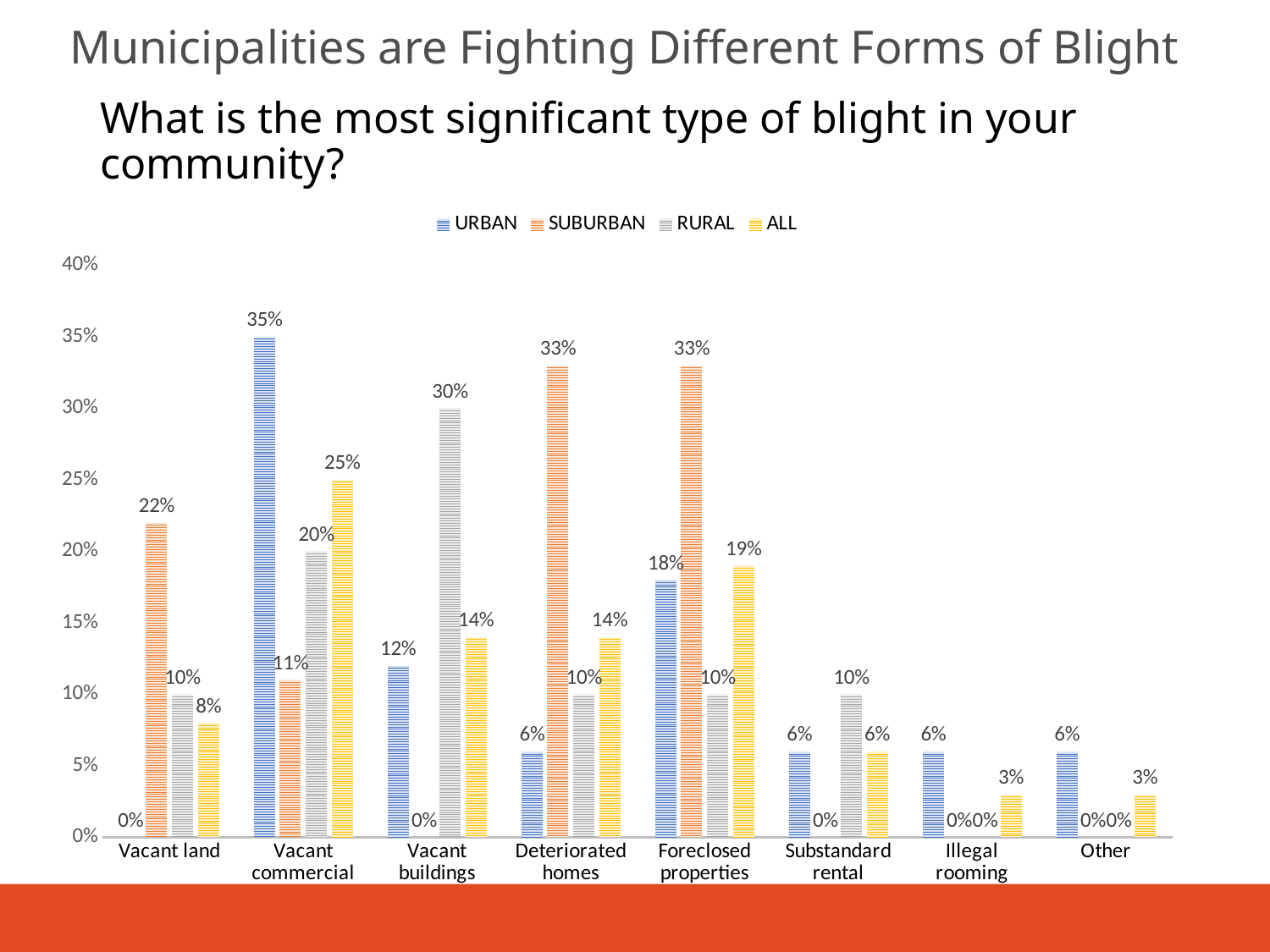
Which category has the highest URBAN value? Vacant commercial Which category has the highest ALL value? Vacant commercial Which is larger for Vacant buildings, the URBAN value or the RURAL value? RURAL What is the ALL value for Foreclosed properties? 19% What kind of chart is shown on the slide? Bar chart How many categories are shown on the x axis? 8 How many series does the legend list? 4 Which series is shown in yellow in the legend? ALL What is the URBAN value for Vacant commercial? 35% What is the difference between the SUBURBAN and URBAN values for Deteriorated homes? 27% What is the SUBURBAN value for Vacant land? 22% What is the RURAL value for Vacant buildings? 30%